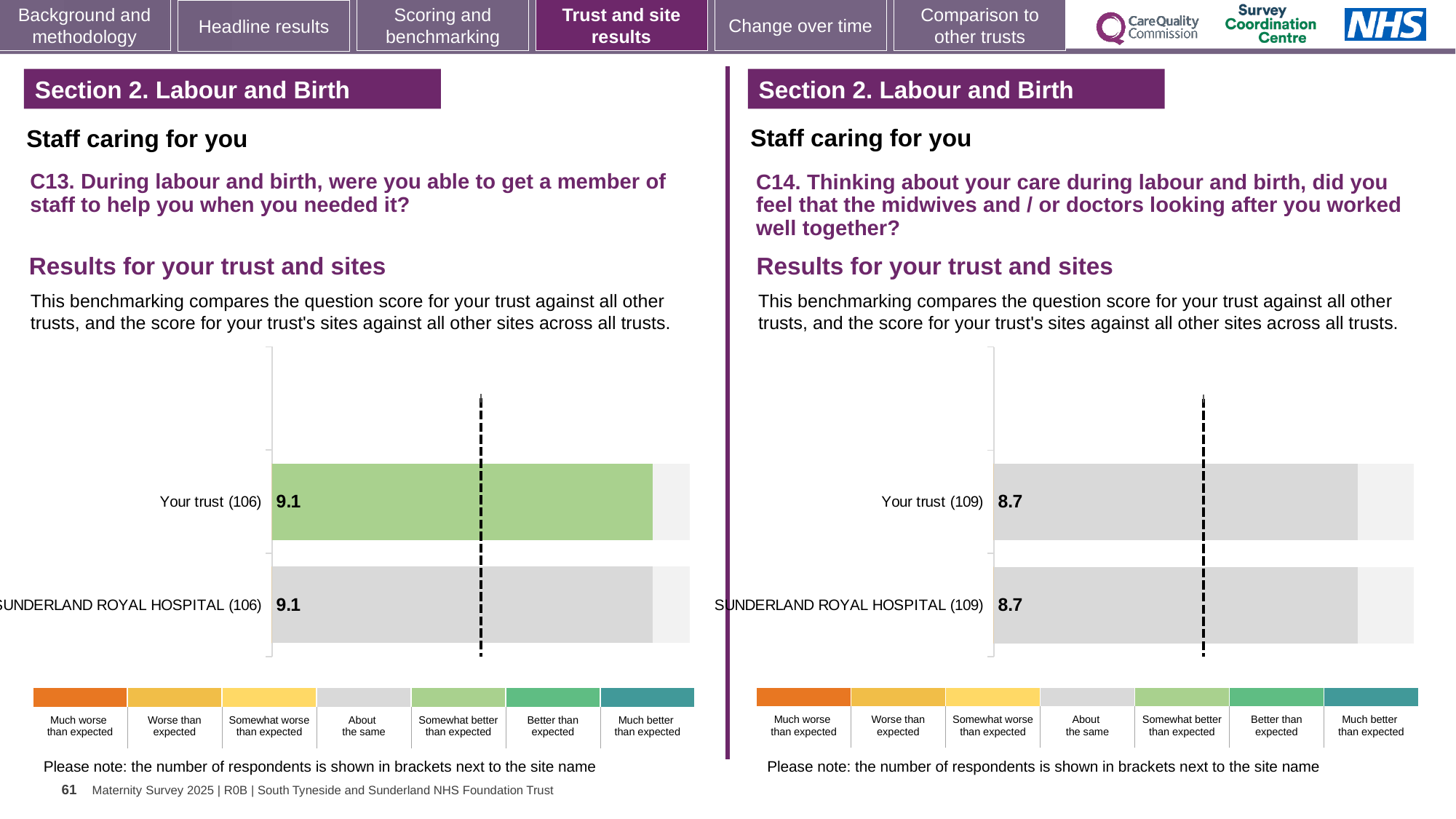
What kind of chart is used for the C13 results (left)? Bar chart On the C14 chart (right), what is the score for SUNDERLAND ROYAL HOSPITAL? 8.7 On the C13 chart (left), what is the score for Your trust? 9.1 On the C13 chart (left), how many respondents are shown in brackets for Your trust? 106 How many bars are plotted on the C13 chart (left)? 2 On the C14 chart (right), how many respondents are shown in brackets for SUNDERLAND ROYAL HOSPITAL? 109 On the C14 chart (right), what is the score for Your trust? 8.7 On the C13 chart (left), what is the score for SUNDERLAND ROYAL HOSPITAL? 9.1 On the C14 chart (right), what is the difference between the Your trust score and the SUNDERLAND ROYAL HOSPITAL score? 0 How many bars are plotted on the C14 chart (right)? 2 Is the Your trust score on the C13 chart (left) larger or smaller than the Your trust score on the C14 chart (right)? Larger On the C13 chart (left), what is the difference between the Your trust score and the SUNDERLAND ROYAL HOSPITAL score? 0